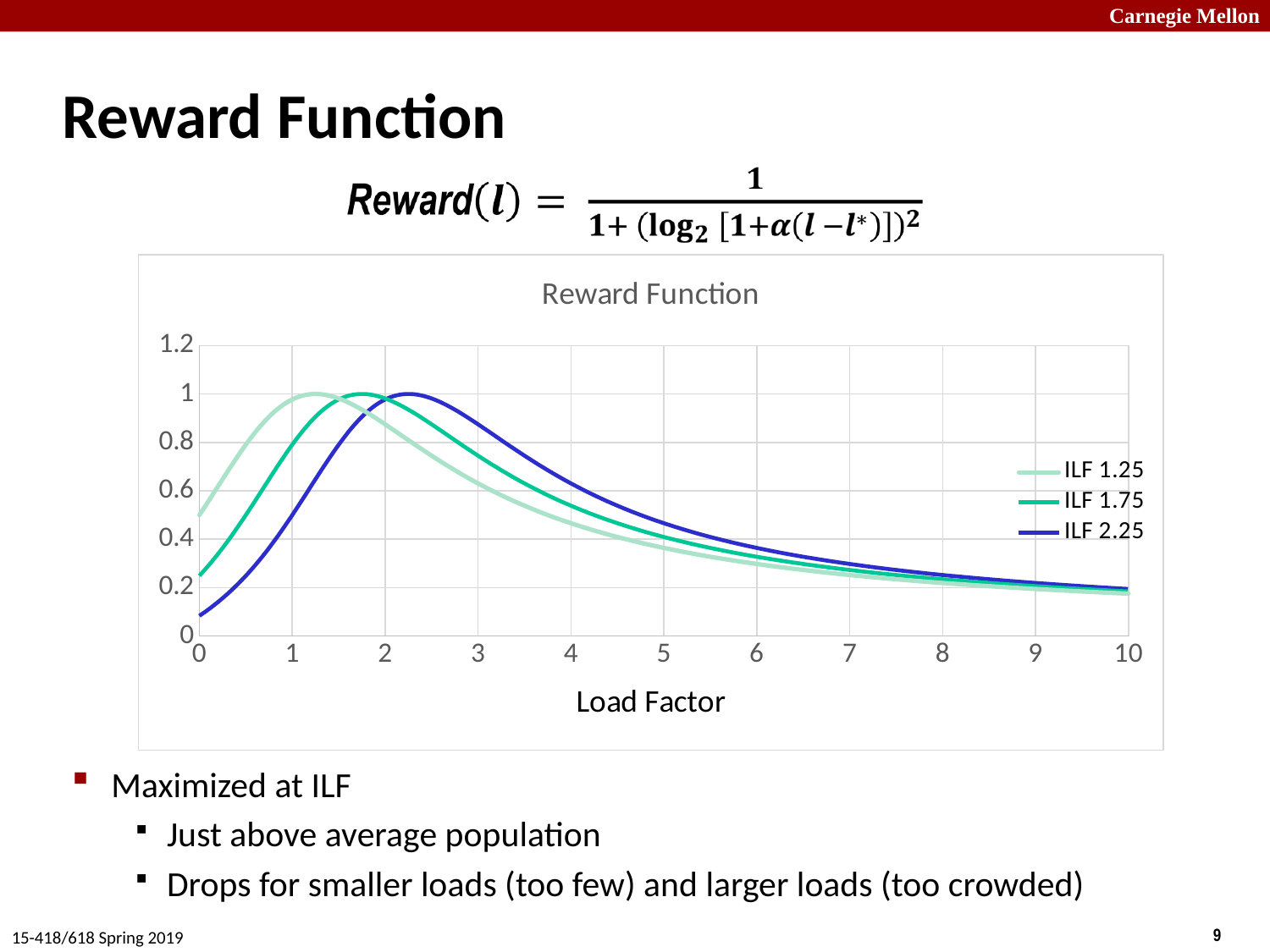
Is the value of ILF 2.25 at load factor 0 greater or less than 0.2? less Which series reaches its peak at the largest load factor? ILF 2.25 How many series does the chart legend list? 3 Do the values of all three series rise or fall as the load factor increases from 4 to 10? fall Which series reaches its peak at the smallest load factor? ILF 1.25 What kind of chart is shown on the slide? line chart Which series has the highest value at load factor 0? ILF 1.25 What is the label of the x axis? Load Factor Which series has the lowest value at load factor 0? ILF 2.25 Is the value of ILF 1.25 at load factor 0 greater or less than 0.4? greater Which series has the highest value at load factor 4? ILF 2.25 What is the title of the chart? Reward Function